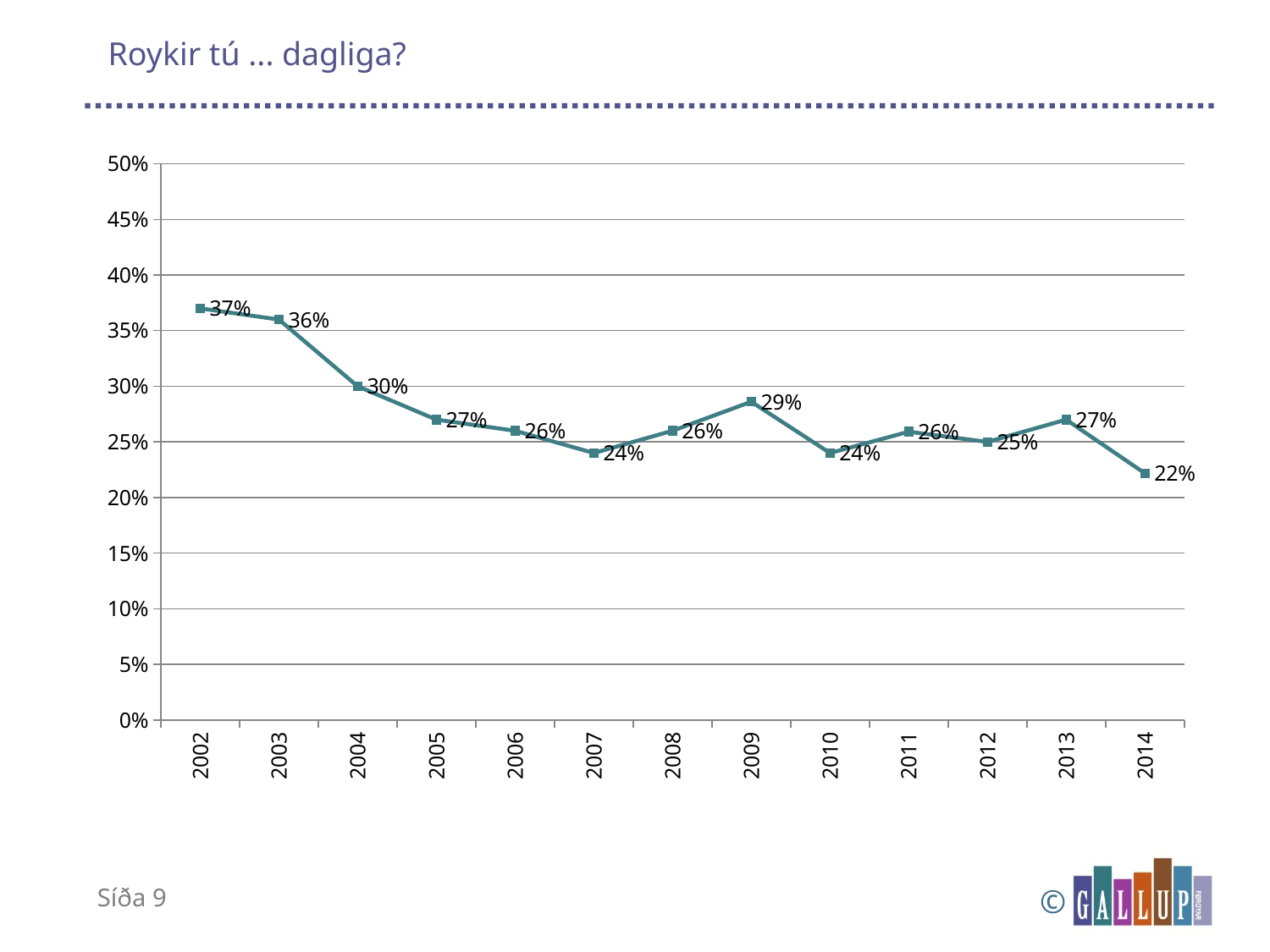
Is the value for 2003 greater or less than 35%? greater What is the value for 2002? 37% What kind of chart is shown on the slide? line chart What is the title of the slide? Roykir tú ... dagliga? How many years are plotted on the x axis? 13 Do the values generally rise or fall from 2002 to 2014? fall Which year has the lowest value? 2014 What is the difference between the values for 2002 and 2014? 15% What is the value for 2014? 22% What is the value for 2009? 29% Which year has the highest value? 2002 Which is larger, the value for 2004 or the value for 2009? 2004